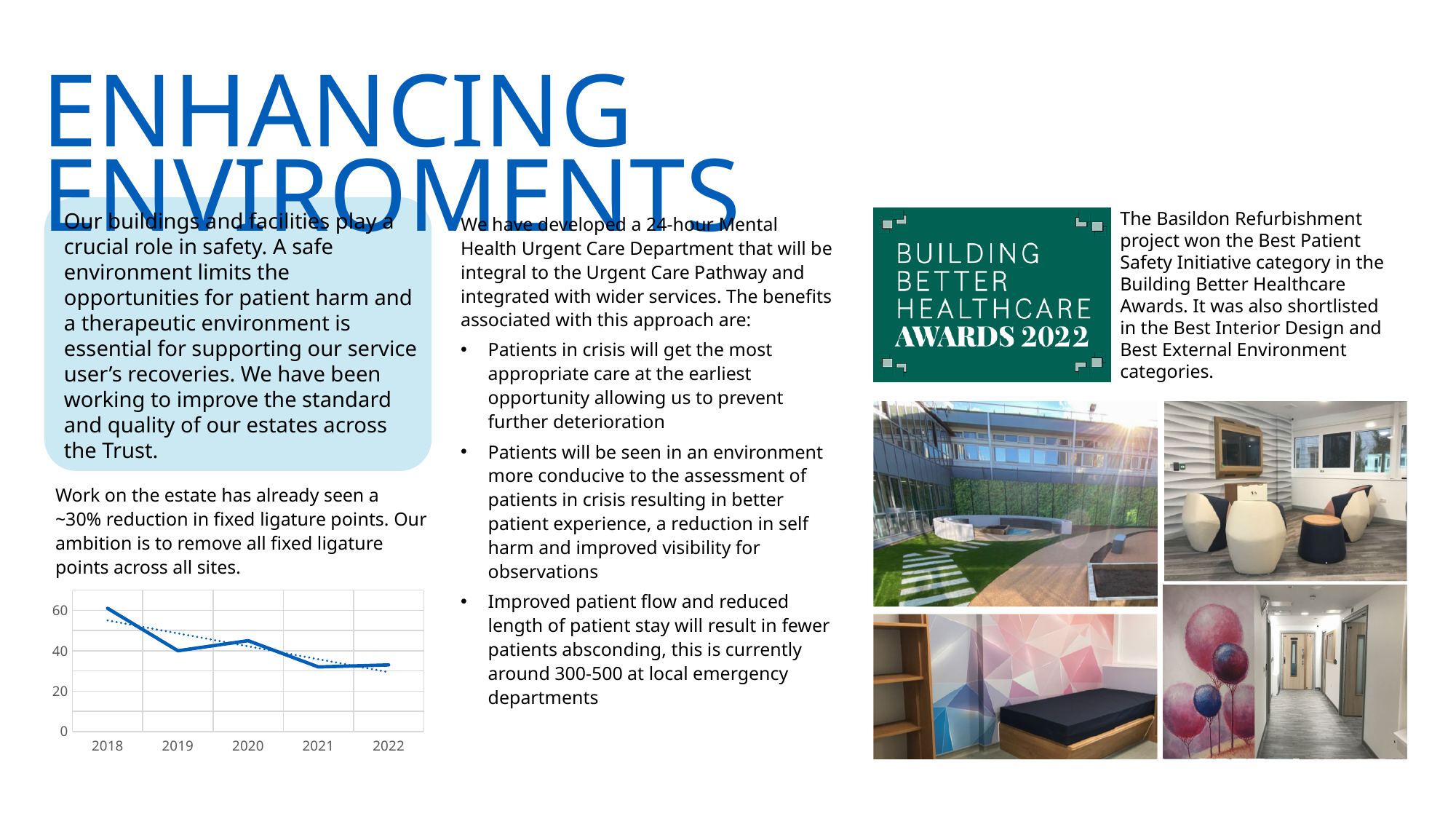
Which year has the larger value on the solid line, 2020 or 2021? 2020 Is the value for 2021 on the solid line greater or less than 40? less What is the first year shown on the x axis of the line chart? 2018 Which year has the larger value on the solid line, 2018 or 2019? 2018 Is the value for 2022 on the solid line greater or less than 20? greater What is the highest tick value shown on the y axis of the line chart? 60 Is the value for 2019 on the solid line greater or less than 60? less Do the values on the solid line generally rise or fall from 2018 to 2022? fall What kind of chart is shown at the bottom left of the slide? line chart How many years are shown on the x axis of the line chart? 5 Which year has the highest value on the solid line of the chart? 2018